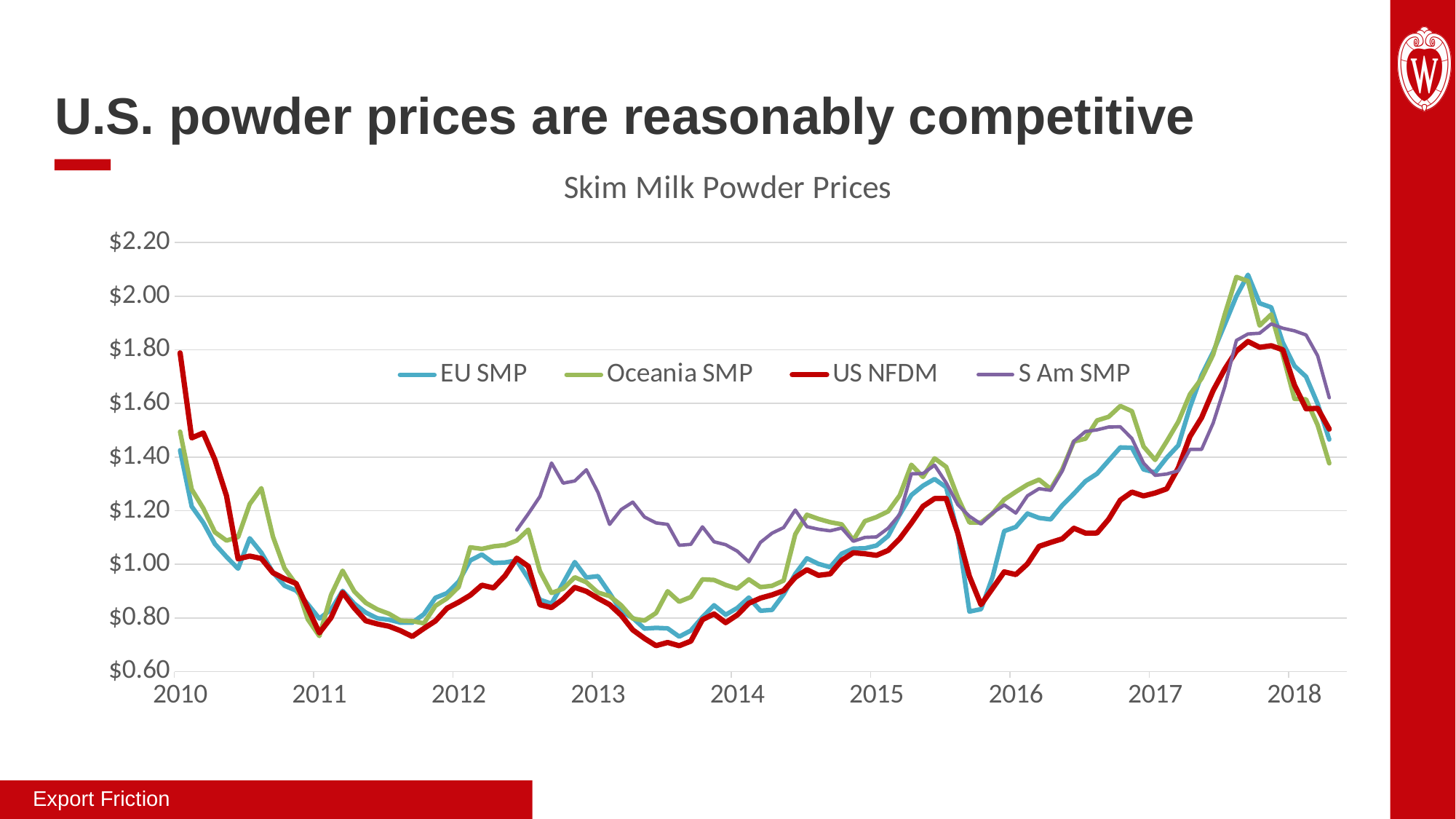
At the right end of the chart in 2018, which series is lowest? Oceania SMP Is the value of US NFDM in mid-2013 greater or less than $0.80? less What kind of chart is shown on the slide? line chart Is the value of S Am SMP in late 2012 greater or less than $1.20? greater Which series in the chart is drawn in red? US NFDM Does the US NFDM price rise or fall from the start of 2010 to the start of 2011? fall How many series does the legend of the Skim Milk Powder Prices chart list? 4 Is the value of US NFDM at the start of 2010 greater or less than $1.60? greater What is the title of the chart on the slide? Skim Milk Powder Prices At the start of 2010, which is higher: US NFDM or EU SMP? US NFDM At the right end of the chart in 2018, which series is highest? S Am SMP